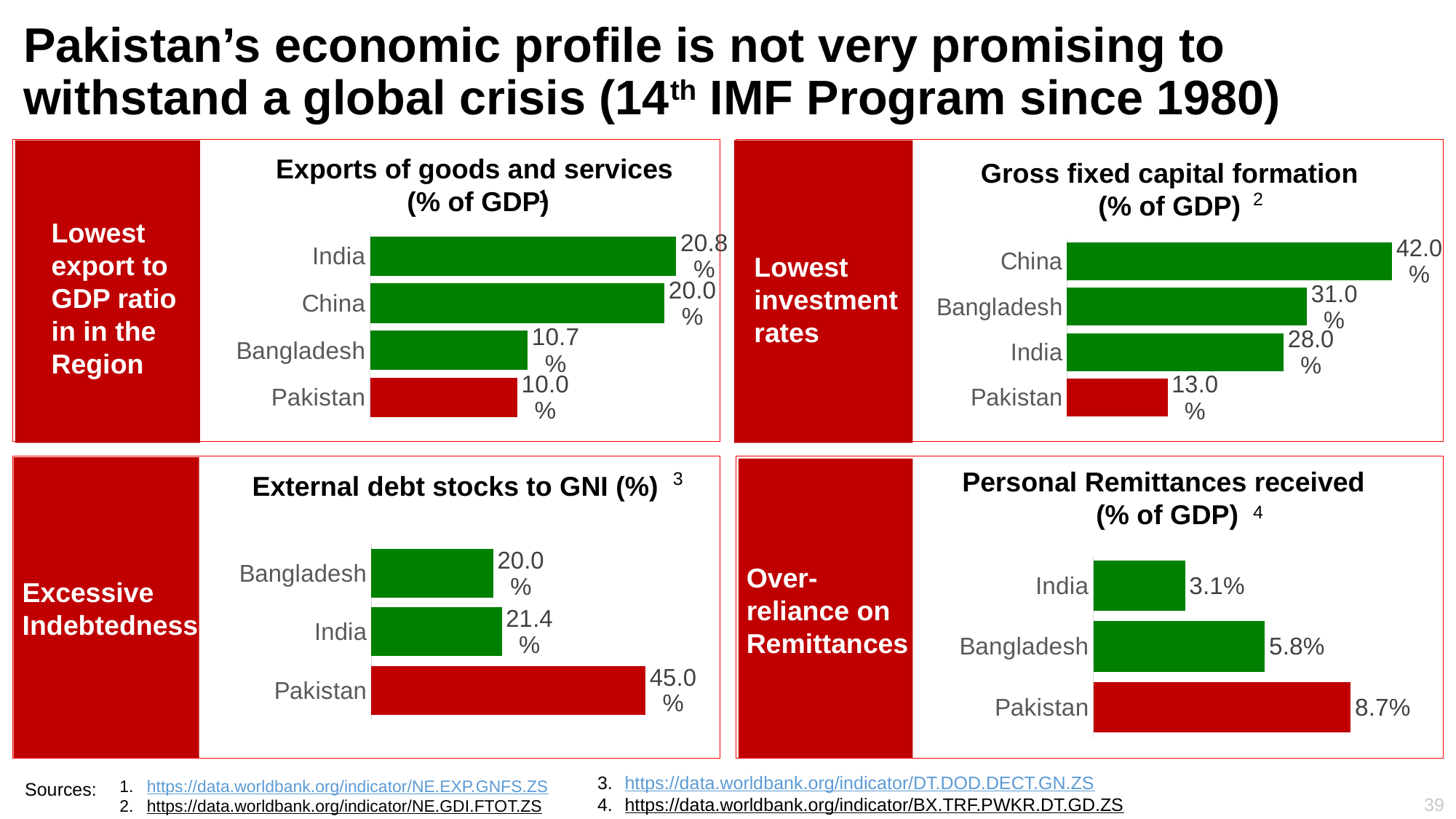
In the 'Exports of goods and services (% of GDP)' chart, which country has the lowest value? Pakistan In the 'Personal Remittances received (% of GDP)' chart, what is the value for Bangladesh? 5.8% In the 'Gross fixed capital formation (% of GDP)' chart, which country has the highest value? China How many countries are shown in the 'Exports of goods and services (% of GDP)' chart? 4 How many countries are shown in the 'External debt stocks to GNI (%)' chart? 3 In the 'External debt stocks to GNI (%)' chart, what is the value for Pakistan? 45.0% In the 'External debt stocks to GNI (%)' chart, which is larger, the value for India or the value for Bangladesh? India In the 'Gross fixed capital formation (% of GDP)' chart, what is the difference between China's and Pakistan's values? 29.0% In the 'Exports of goods and services (% of GDP)' chart, what is the value for India? 20.8% In the 'Personal Remittances received (% of GDP)' chart, what is the difference between Pakistan's and India's values? 5.6% In the 'Gross fixed capital formation (% of GDP)' chart, what is the value for Bangladesh? 31.0% What type of chart is the 'Exports of goods and services (% of GDP)' chart? Bar chart